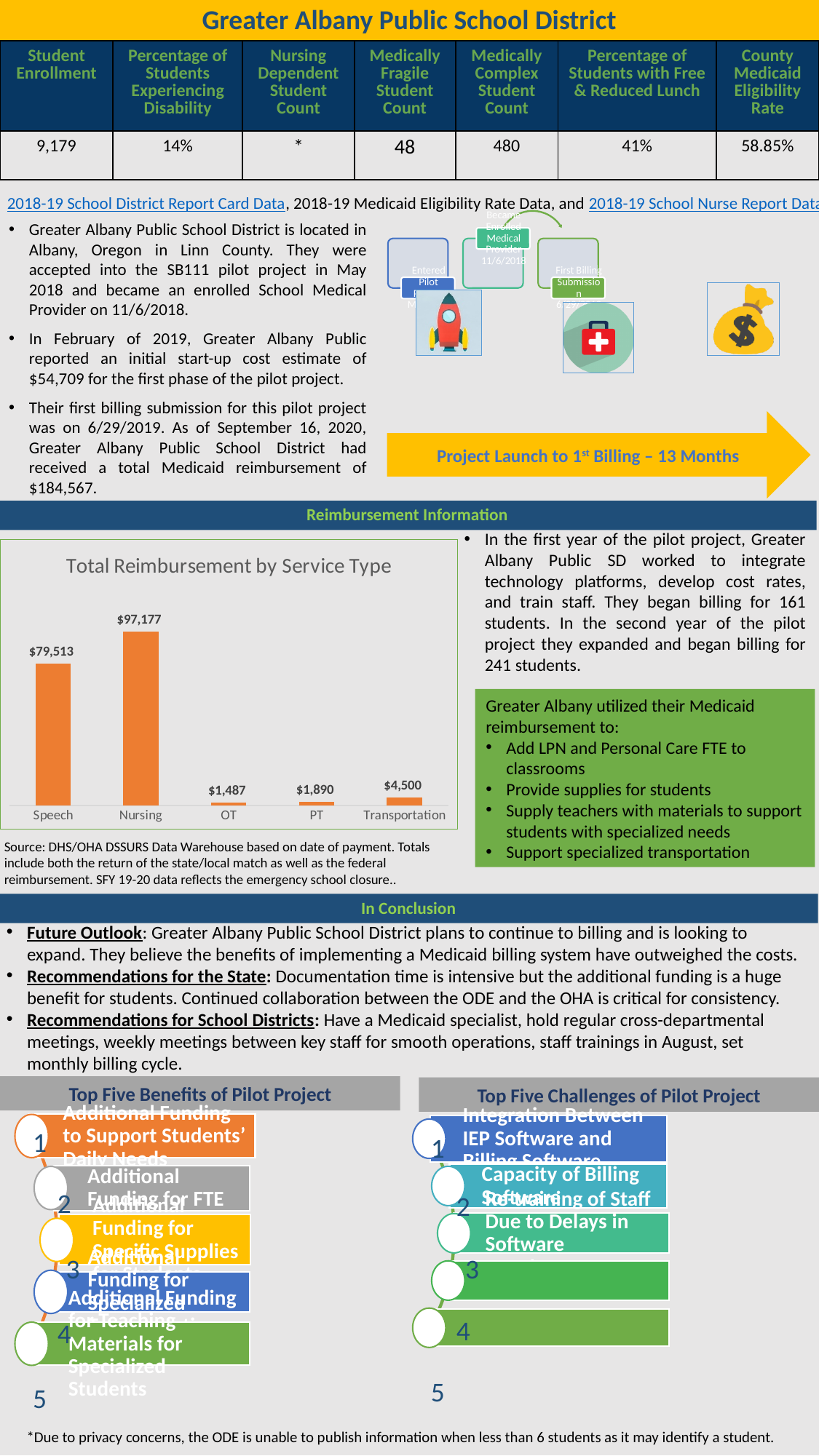
Which service type has the highest total reimbursement in the 'Total Reimbursement by Service Type' chart? Nursing Which service type has the lowest total reimbursement in the 'Total Reimbursement by Service Type' chart? OT What is the total reimbursement for Speech in the 'Total Reimbursement by Service Type' chart? $79,513 In the 'Total Reimbursement by Service Type' chart, what is the difference between the PT and OT reimbursements? $403 What is the title of the chart in the Reimbursement Information section? Total Reimbursement by Service Type What kind of chart is 'Total Reimbursement by Service Type'? Bar chart In the 'Total Reimbursement by Service Type' chart, which is larger: the reimbursement for PT or for Transportation? Transportation What is the total reimbursement for OT in the 'Total Reimbursement by Service Type' chart? $1,487 In the 'Total Reimbursement by Service Type' chart, what is the difference between the Nursing and Speech reimbursements? $17,664 What is the total reimbursement for Transportation in the 'Total Reimbursement by Service Type' chart? $4,500 How many service types are shown in the 'Total Reimbursement by Service Type' chart? 5 What is the total reimbursement for Nursing in the 'Total Reimbursement by Service Type' chart? $97,177